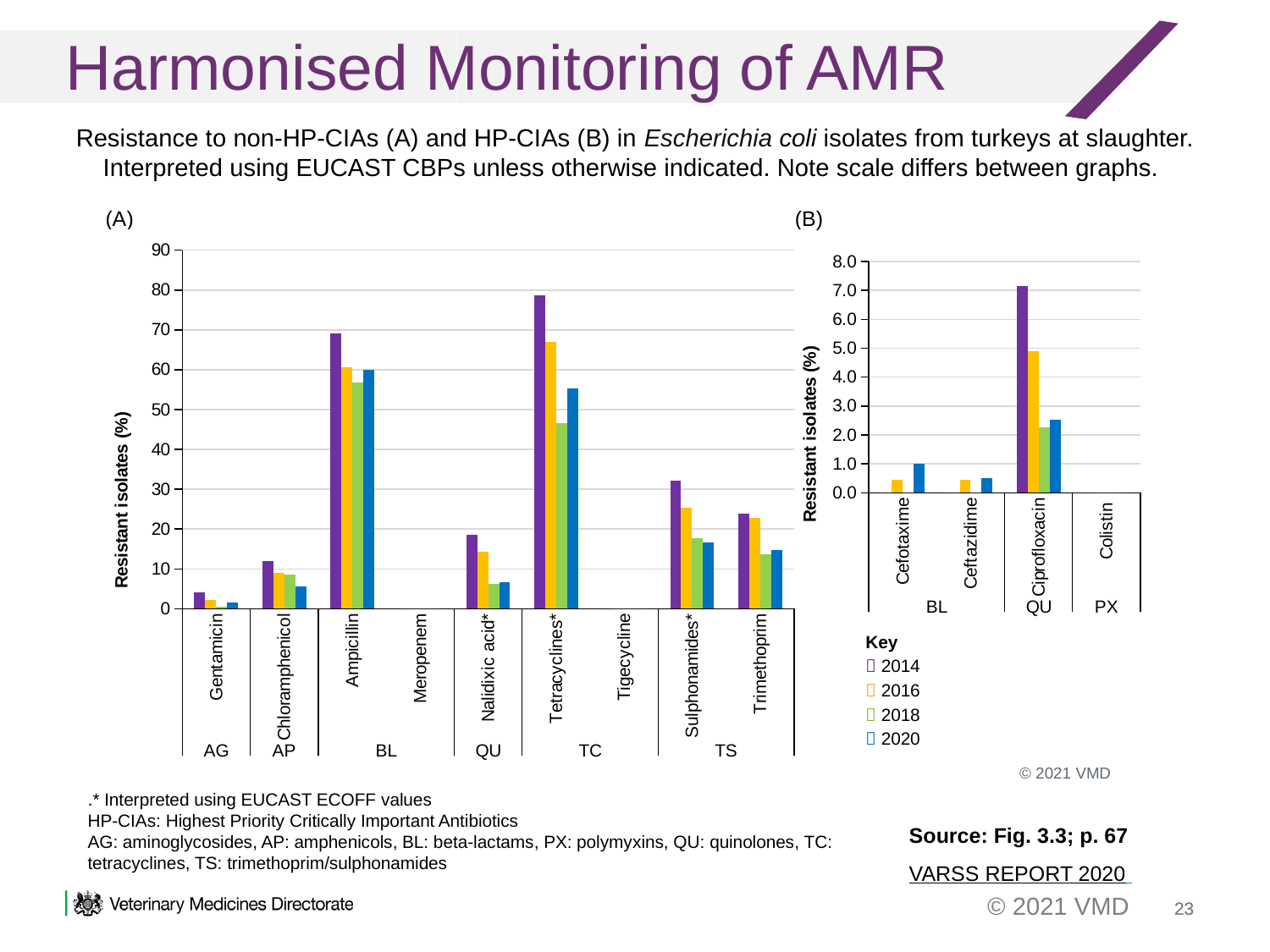
In chart (B), is the 2014 value for Ciprofloxacin greater or less than 6.0? greater What kind of chart is chart (A)? bar chart What is the y-axis label of chart (A)? Resistant isolates (%) In chart (A), is the 2014 value for Gentamicin greater or less than 10? less In chart (A), which is larger for 2014: Nalidixic acid* or Chloramphenicol? Nalidixic acid* How many antibiotics are shown along the x axis of chart (A)? 9 How many antibiotics are shown along the x axis of chart (B)? 4 How many series does the key list for the charts? 4 In chart (A), do the values for Sulphonamides* rise or fall from 2014 to 2020? fall In chart (A), is the 2014 value for Ampicillin greater or less than 60? greater In chart (B), which antibiotic has the highest resistance values? Ciprofloxacin In chart (A), which antibiotic has the highest 2014 value? Tetracyclines*